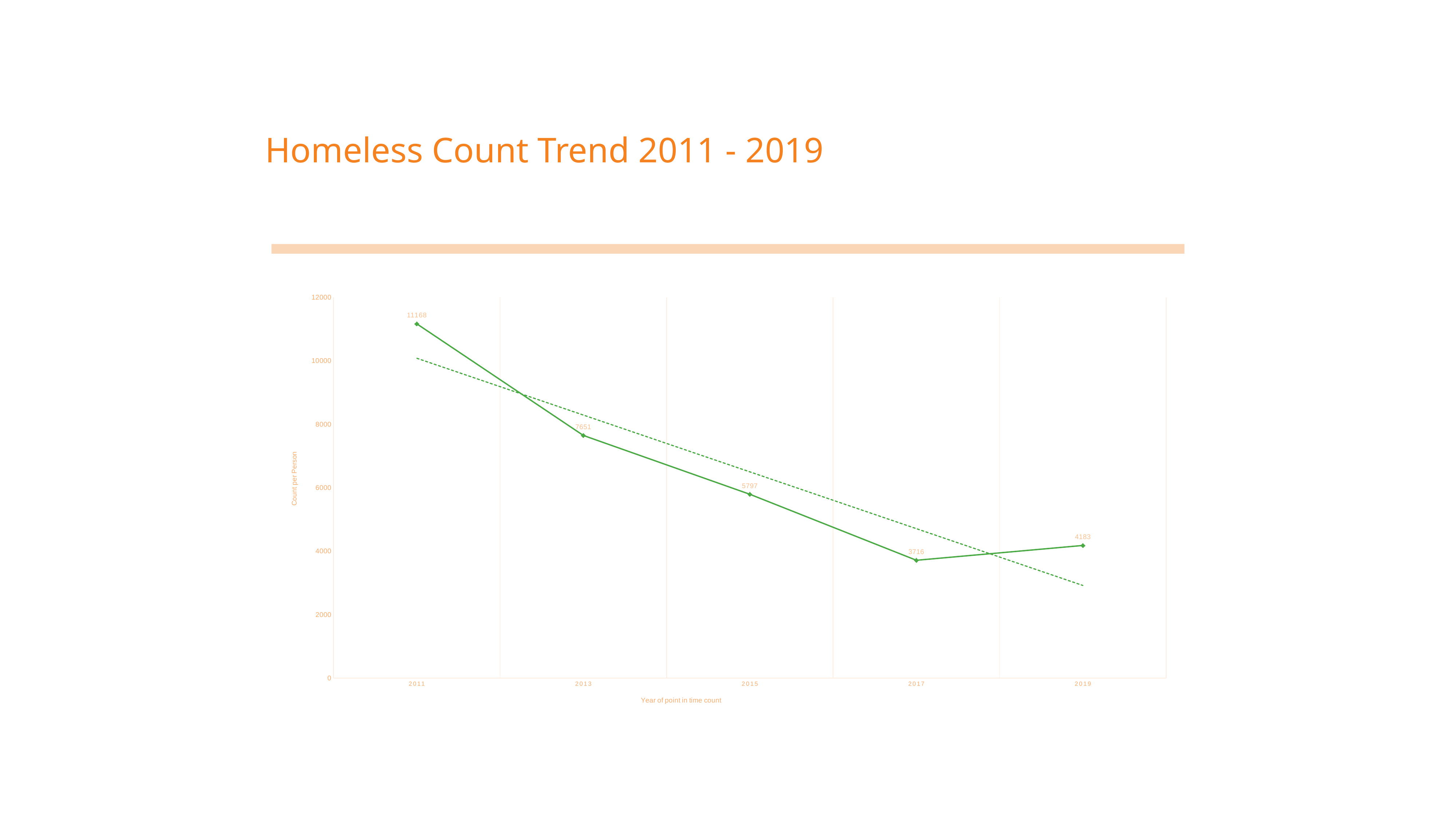
What is the homeless count for 2013? 7651 What is the homeless count for 2017? 3716 Which is larger, the homeless count in 2017 or in 2019? 2019 What is the homeless count for 2011? 11168 What is the homeless count for 2019? 4183 Which year has the lowest homeless count? 2017 What is the label of the x axis? Year of point in time count What kind of chart is shown on the slide? Line chart How many years are plotted on the chart? 5 What is the difference between the homeless count in 2011 and in 2013? 3517 Does the homeless count rise or fall from 2011 to 2017? Fall Which year has the highest homeless count? 2011